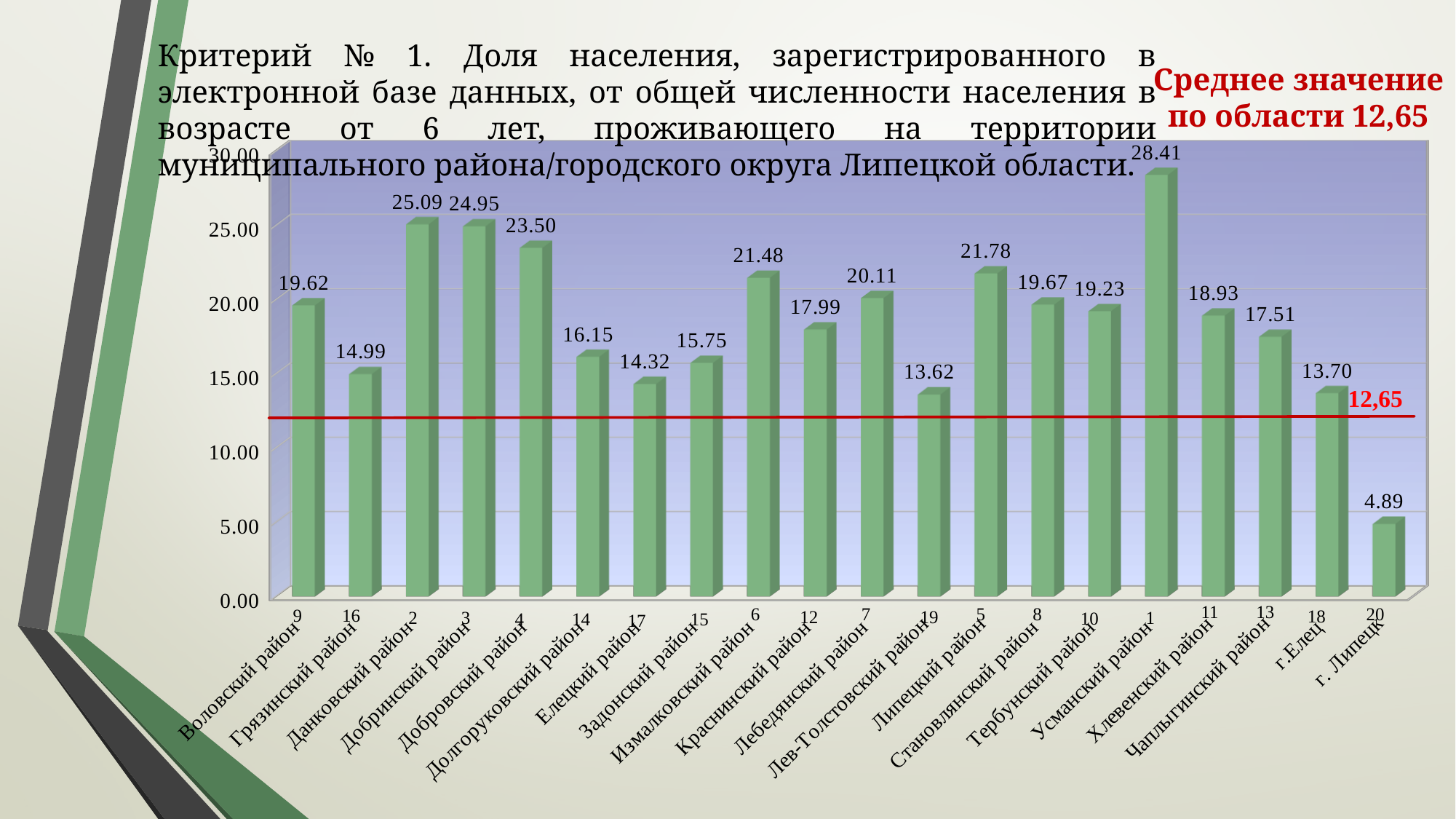
What is the value for Усманский район? 28.41 What kind of chart is shown on the slide? Bar chart How many categories are shown on the x axis? 20 Which category has the highest value? Усманский район What value does the red horizontal line across the chart represent? 12,65 What is the difference between the values for Данковский район and Добринский район? 0.14 What is the difference between the values for Усманский район and г. Липецк? 23.52 What is the value for г. Липецк? 4.89 What is the value for Воловский район? 19.62 Which is larger, the value for Измалковский район or the value for Липецкий район? Липецкий район What is the value for Лев-Толстовский район? 13.62 Which category has the lowest value? г. Липецк